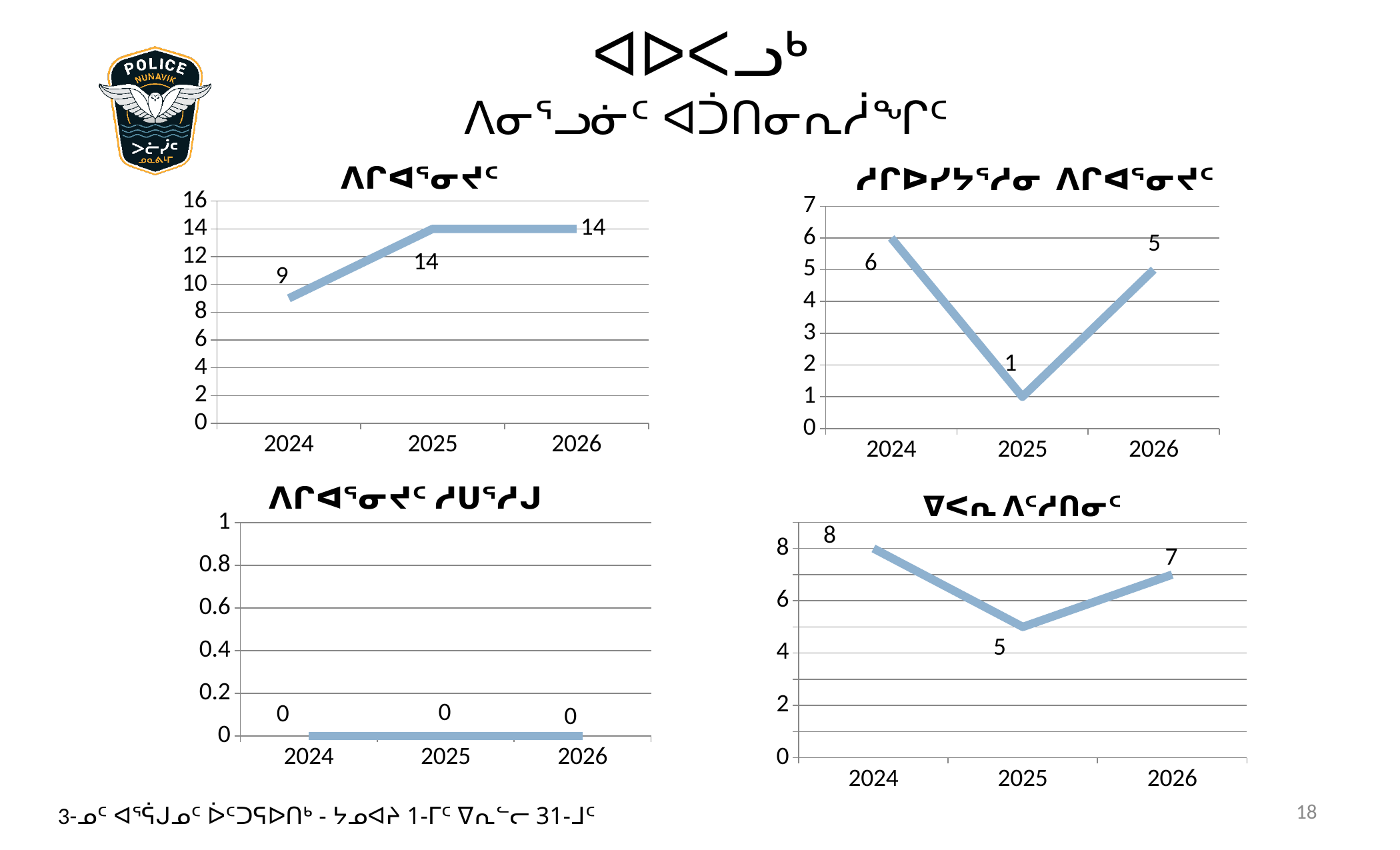
In the bottom-right chart, which year has the highest value? 2024 In the top-left chart, what is the value for 2026? 14 In the bottom-right chart, what is the value for 2025? 5 In the top-right chart, which year has the lowest value? 2025 In the top-left chart, what is the value for 2024? 9 What kind of chart is the top-right chart? Line chart In the top-right chart, is the value for 2024 larger or the value for 2026? 2024 In the top-left chart, what is the difference between the 2025 value and the 2024 value? 5 In the bottom-left chart, what is the value for 2025? 0 In the top-right chart, what is the value for 2024? 6 In the bottom-left chart, how many years are plotted on the x axis? 3 In the bottom-right chart, what is the difference between the 2024 value and the 2026 value? 1